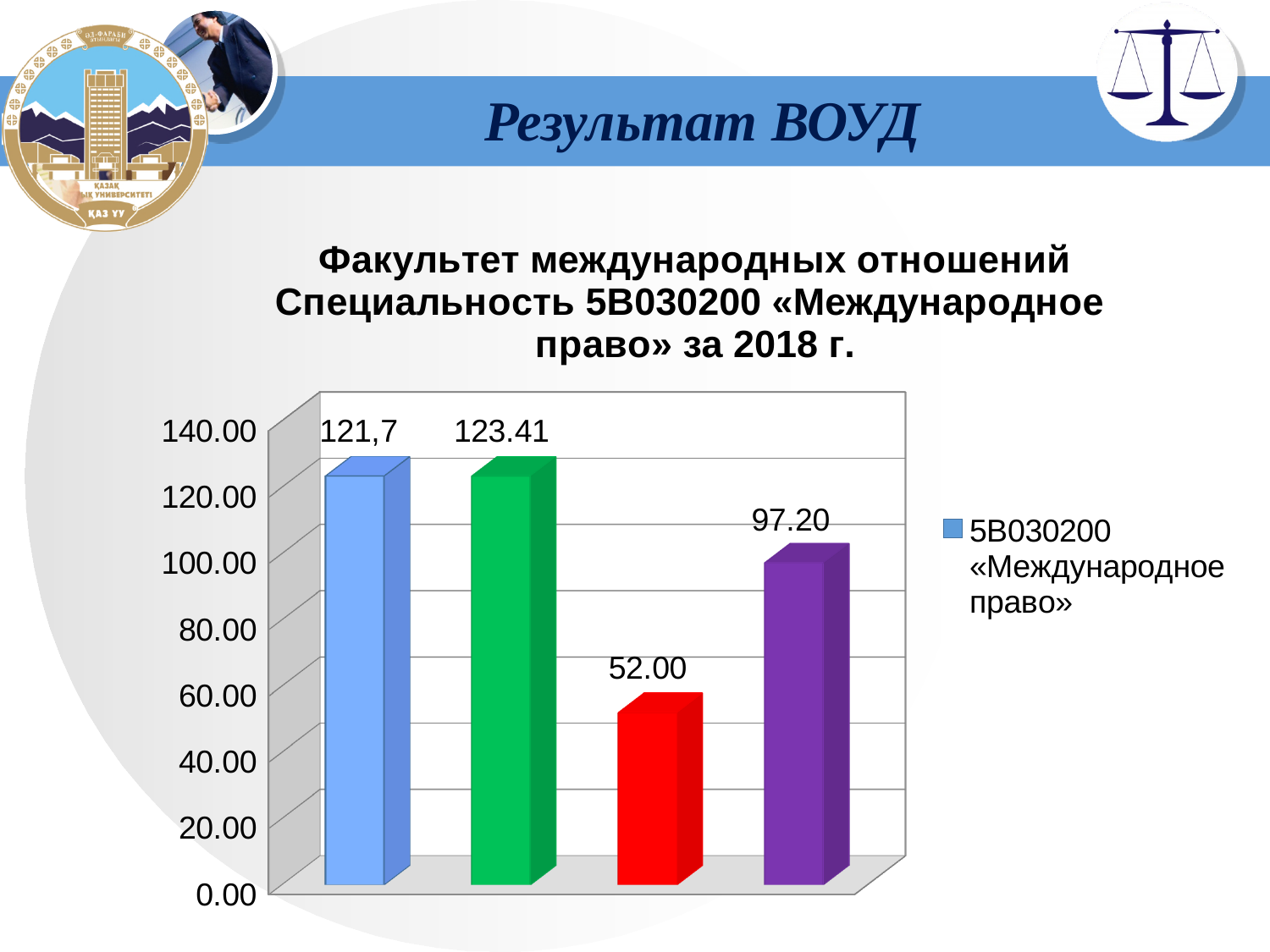
How many bars are plotted in the chart? 4 Which bar has the lowest value? the third (red) bar, 52.00 What is the value shown on the fourth (purple) bar? 97.20 Which is larger, the value of the fourth (purple) bar or the third (red) bar? the fourth (purple) bar What type of chart is shown on the slide? bar chart Which bar has the highest value? the second (green) bar, 123.41 What is the value shown on the second (green) bar? 123.41 What is the difference between the values of the second (green) bar and the third (red) bar? 71.41 What is the value shown on the first (blue) bar? 121,7 What is the value shown on the third (red) bar? 52.00 How many series does the legend list? 1 What series name is shown in the chart legend? 5B030200 «Международное право»